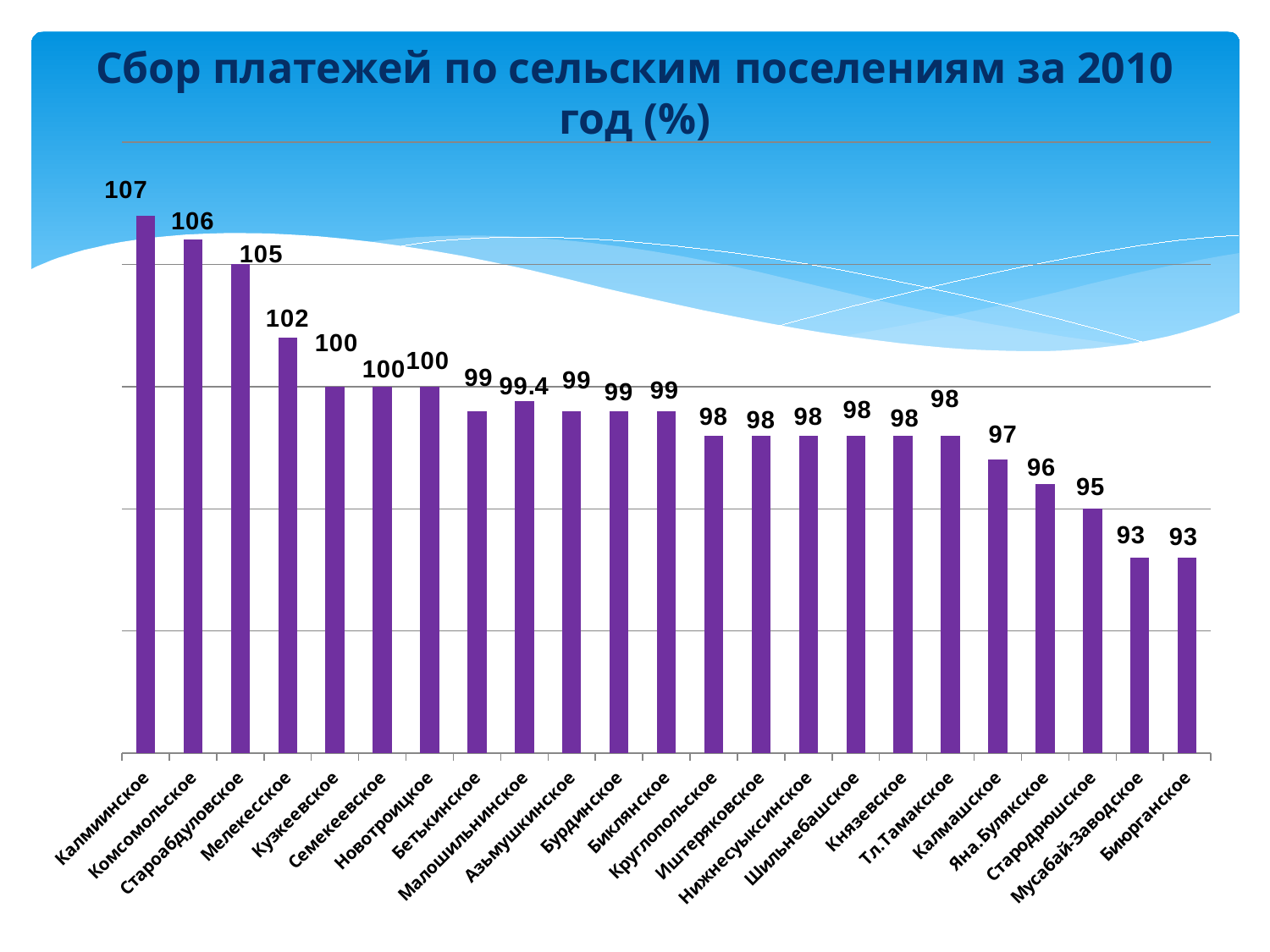
How many settlements are shown on the chart? 23 Do the values generally rise or fall from left to right along the x axis? Fall What is the value for Калмиинское? 107 What is the difference between the values for Комсомольское and Мелекесское? 4 What is the value for Стародрюшское? 95 What kind of chart is shown on the slide? Bar chart What is the value for Малошильнинское? 99.4 What is the difference between the values for Калмиинское and Биюрганское? 14 What is the value for Мелекесское? 102 What is the lowest value shown on the chart? 93 Which settlement has the highest value? Калмиинское Which is larger, the value for Староабдуловское or the value for Калмашское? Староабдуловское